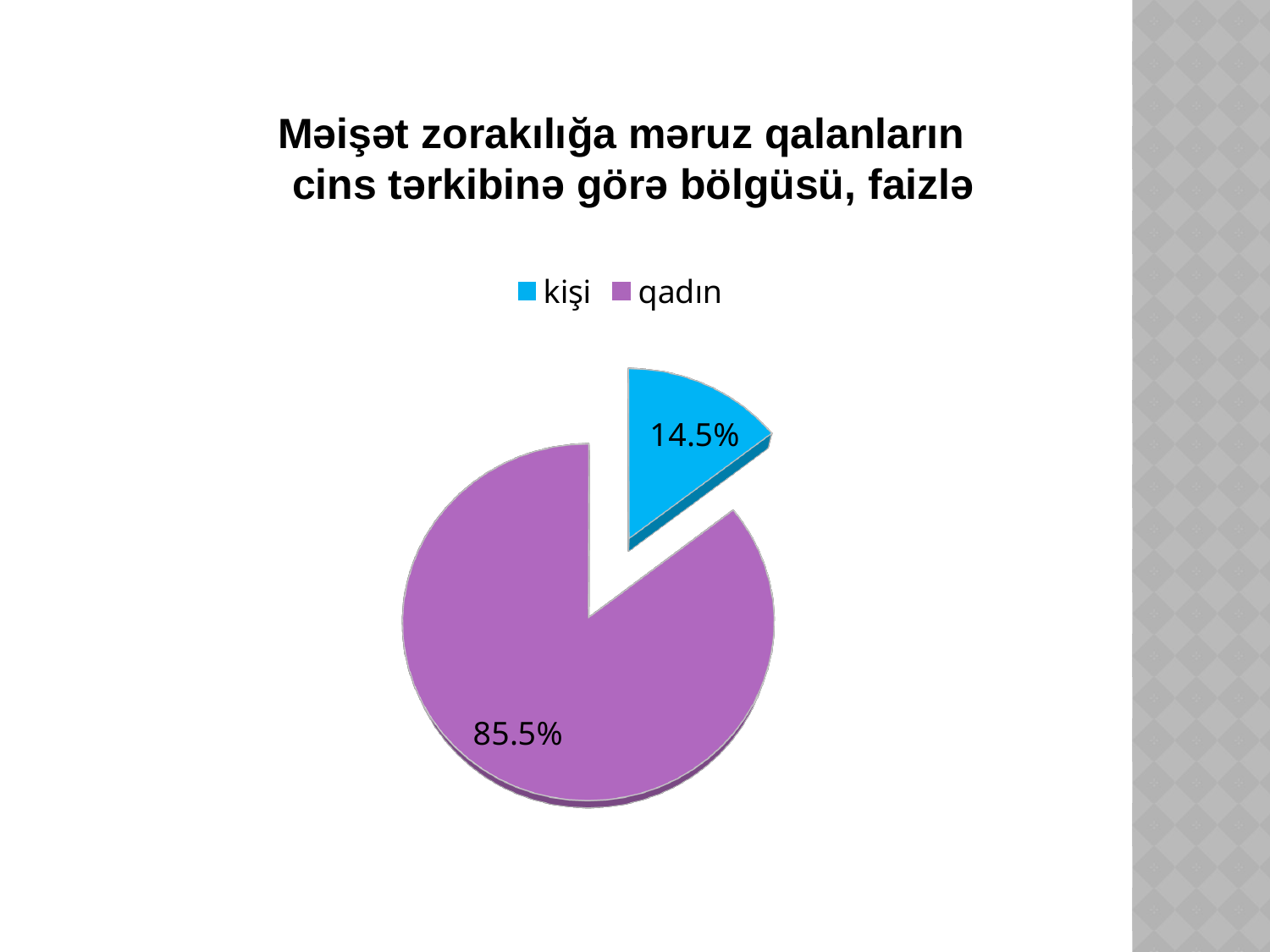
What colour is the 'kişi' slice? blue What is the difference in percentage points between the 'qadın' and 'kişi' slices? 71 percentage points What share of the pie does the 'qadın' slice represent? 85.5% Which category has the smallest slice of the pie? kişi Which category has the largest slice of the pie? qadın How many entries does the legend list? 2 What kind of chart is shown on the slide? pie chart How many slices does the pie chart have? 2 What is the title of the chart? Məişət zorakılığa məruz qalanların cins tərkibinə görə bölgüsü, faizlə Which is larger, the 'kişi' slice or the 'qadın' slice? qadın What share of the pie does the 'kişi' slice represent? 14.5%